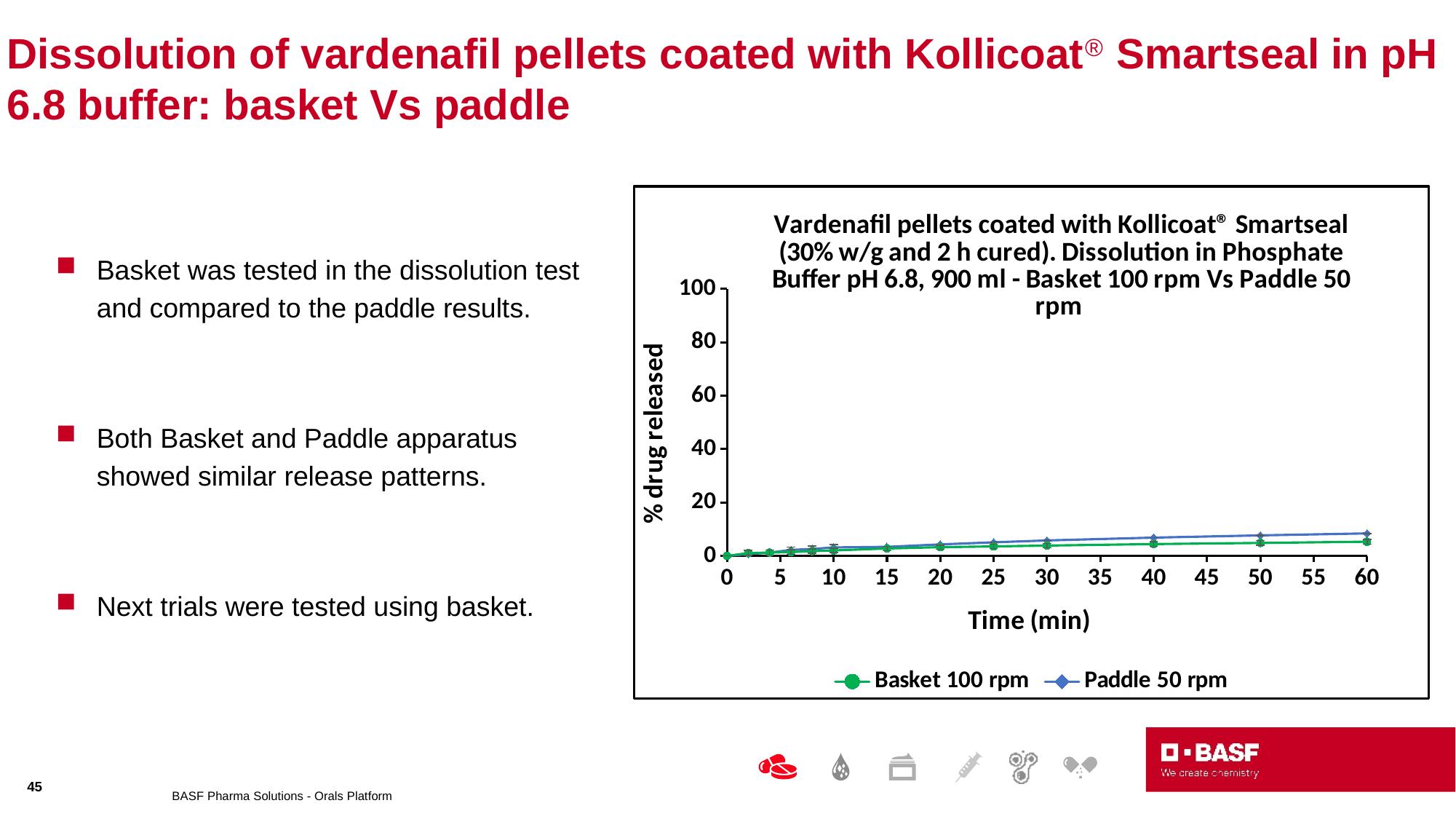
How many series does the chart legend list? 2 What is the label of the y axis of the chart? % drug released What kind of chart is shown on the slide? line chart Do the values for Basket 100 rpm rise or fall as time increases along the x axis? rise At 60 min, which series has the higher % drug released, Basket 100 rpm or Paddle 50 rpm? Paddle 50 rpm What are the two series named in the chart legend? Basket 100 rpm and Paddle 50 rpm Is the value for Basket 100 rpm at 60 min greater or less than 20? less Is the value for Paddle 50 rpm at 30 min greater or less than 40? less Is the value for Paddle 50 rpm at 60 min greater or less than 20? less What is the highest value shown on the y axis of the chart? 100 Do the values for Paddle 50 rpm rise or fall as time increases along the x axis? rise